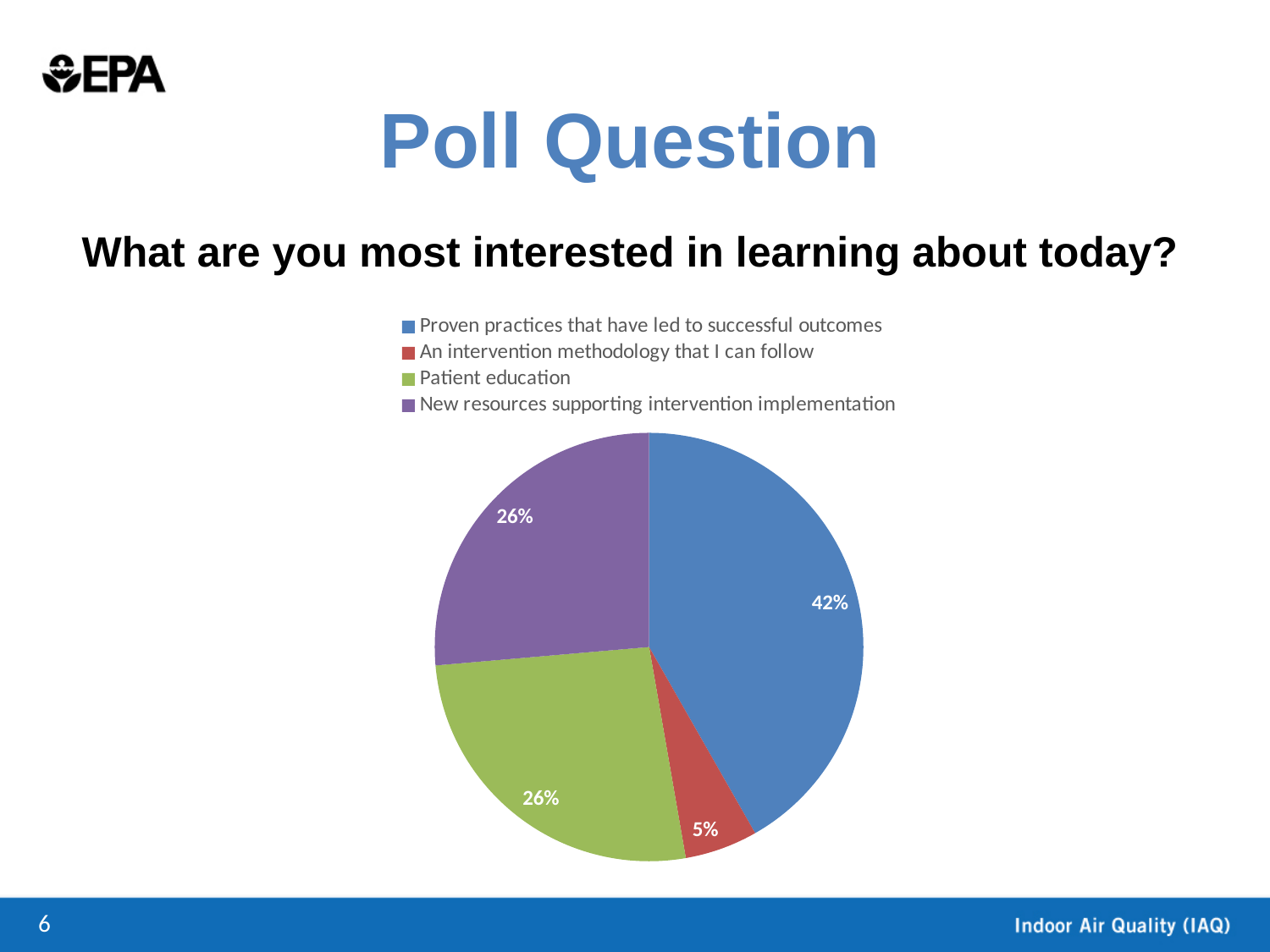
What share of the pie is labelled for 'Patient education'? 26% How many entries does the legend list? 4 Which category has the largest slice of the pie? Proven practices that have led to successful outcomes By how many percentage points does 'Proven practices that have led to successful outcomes' exceed 'An intervention methodology that I can follow'? 37 percentage points How many slices does the pie chart have? 4 What share of the pie is labelled for 'An intervention methodology that I can follow'? 5% What colour is the slice for 'Patient education'? Green Which is larger: the slice for 'Patient education' or the slice for 'An intervention methodology that I can follow'? Patient education What share of the pie is labelled for 'Proven practices that have led to successful outcomes'? 42% Which category has the smallest slice of the pie? An intervention methodology that I can follow What type of chart is shown on the slide? Pie chart